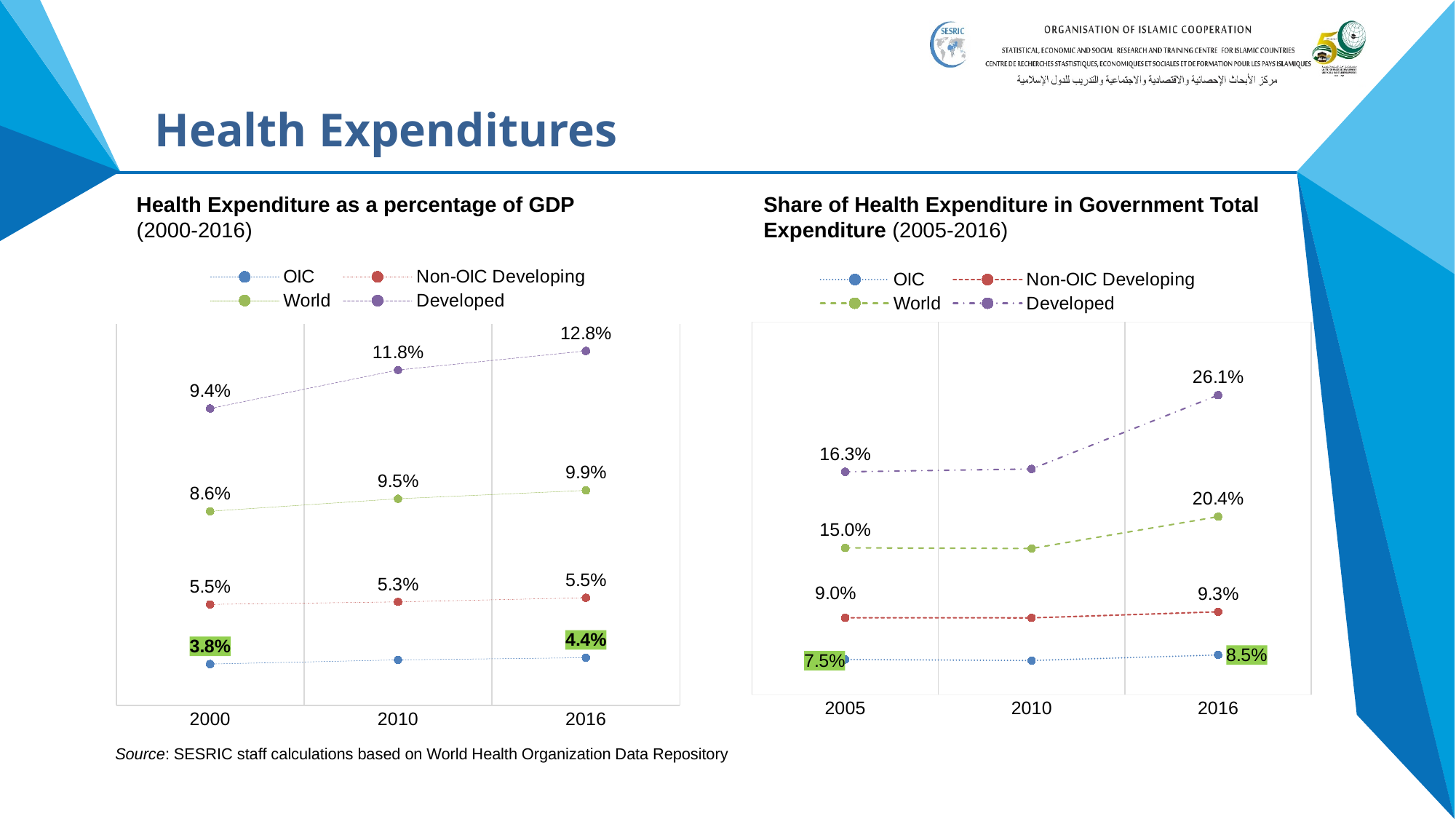
In the 'Share of Health Expenditure in Government Total Expenditure' chart, what is the difference between the OIC values in 2016 and 2005? 1.0% In the 'Share of Health Expenditure in Government Total Expenditure' chart, what is the value for Developed in 2016? 26.1% In the 'Health Expenditure as a percentage of GDP' chart, which series has the highest value in 2016? Developed In the 'Health Expenditure as a percentage of GDP' chart, what is the value for Developed in 2016? 12.8% In the 'Health Expenditure as a percentage of GDP' chart, what is the value for OIC in 2000? 3.8% In the 'Health Expenditure as a percentage of GDP' chart, which series has the lowest value in 2000? OIC In the 'Share of Health Expenditure in Government Total Expenditure' chart, what is the value for Non-OIC Developing in 2005? 9.0% How many series does the legend of the 'Share of Health Expenditure in Government Total Expenditure' chart list? 4 In the 'Health Expenditure as a percentage of GDP' chart, what is the value for World in 2010? 9.5% In the 'Share of Health Expenditure in Government Total Expenditure' chart, which is larger in 2016: World or Non-OIC Developing? World In the 'Health Expenditure as a percentage of GDP' chart, does the Developed series rise or fall from 2000 to 2016? rise In the 'Health Expenditure as a percentage of GDP' chart, what is the difference between the Developed and OIC values in 2016? 8.4%